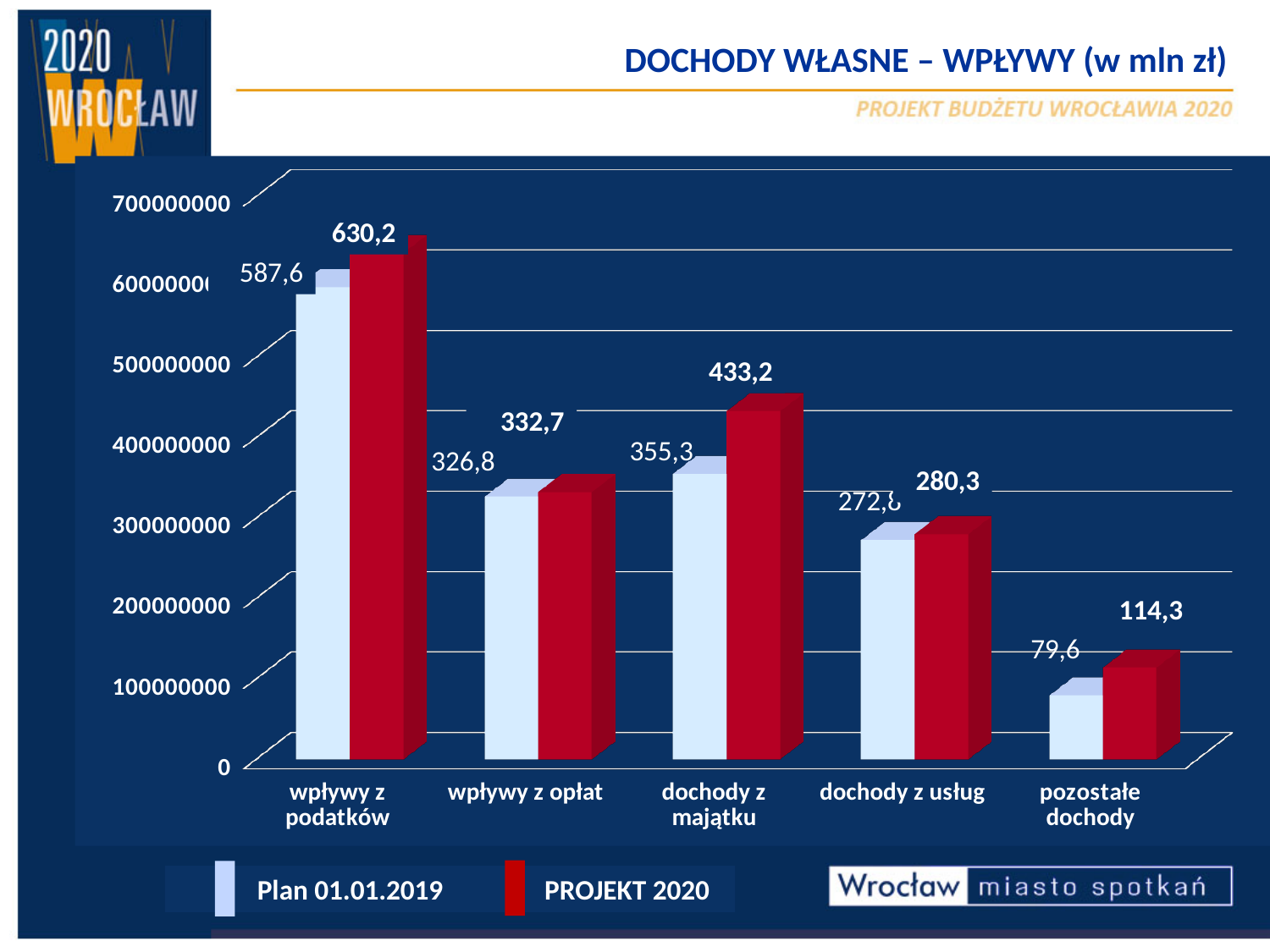
What kind of chart is shown on the slide? bar chart Which is larger for dochody z usług: the Plan 01.01.2019 value or the PROJEKT 2020 value? PROJEKT 2020 How many series does the legend list? 2 What is the difference between the PROJEKT 2020 and Plan 01.01.2019 values for dochody z majątku? 77,9 Which category has the highest PROJEKT 2020 value? wpływy z podatków What is the PROJEKT 2020 value for wpływy z podatków? 630,2 Which category has the lowest Plan 01.01.2019 value? pozostałe dochody What is the Plan 01.01.2019 value for wpływy z opłat? 326,8 What is the difference between the PROJEKT 2020 and Plan 01.01.2019 values for wpływy z podatków? 42,6 How many categories are shown on the x axis? 5 What is the Plan 01.01.2019 value for dochody z majątku? 355,3 What is the PROJEKT 2020 value for pozostałe dochody? 114,3